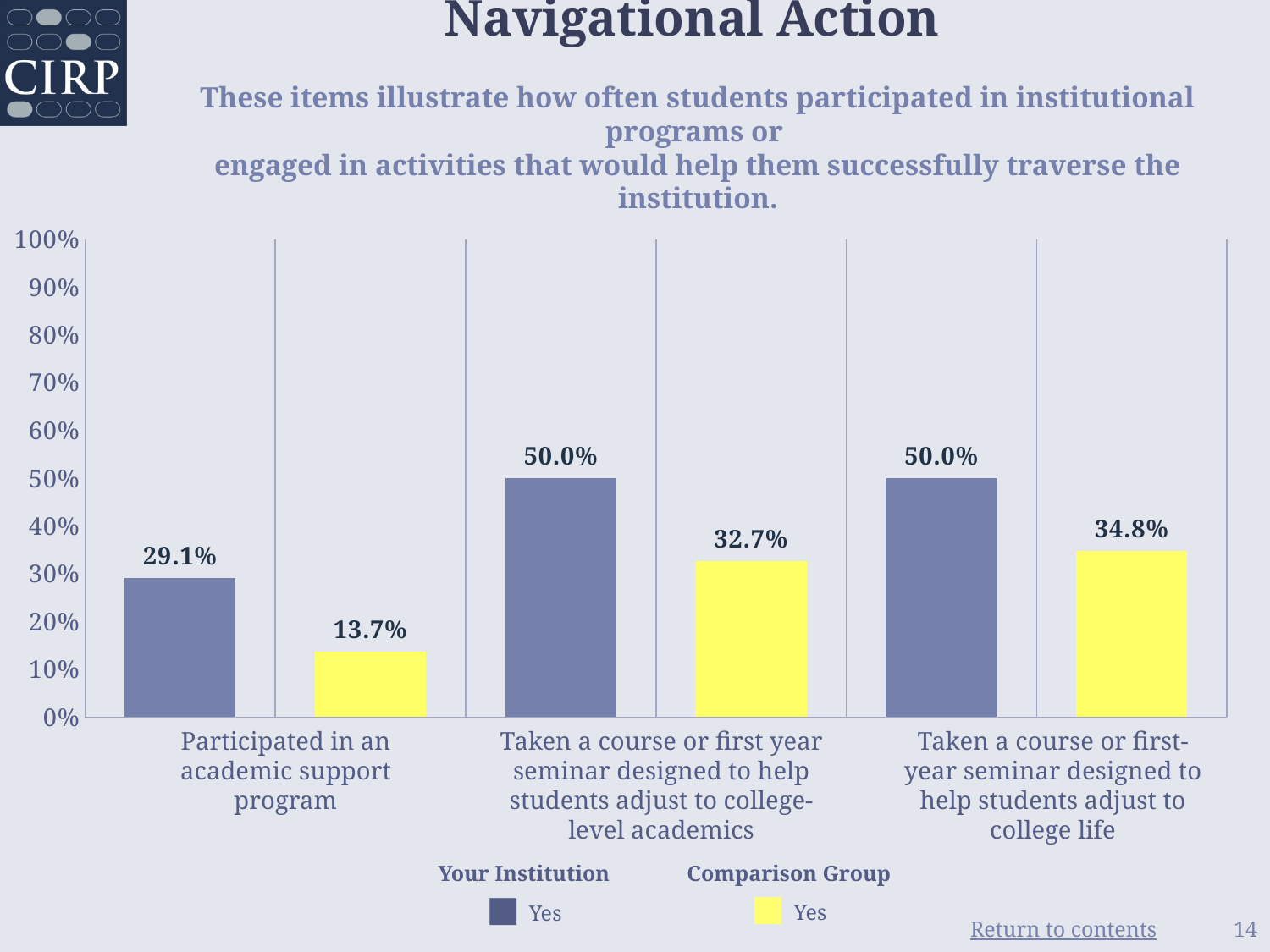
What is the value for Your Institution for 'Participated in an academic support program'? 29.1% What kind of chart is shown on the slide? Bar chart What is the Your Institution value for 'Taken a course or first-year seminar designed to help students adjust to college life'? 50.0% How many categories are shown on the x axis? 3 How many series does the legend list? 2 What is the Comparison Group value for 'Taken a course or first year seminar designed to help students adjust to college-level academics'? 32.7% What is the difference between Your Institution and the Comparison Group for 'Participated in an academic support program'? 15.4% Which is larger for 'Taken a course or first-year seminar designed to help students adjust to college life': Your Institution or the Comparison Group? Your Institution What is the Comparison Group value for 'Taken a course or first-year seminar designed to help students adjust to college life'? 34.8% What is the difference between Your Institution and the Comparison Group for 'Taken a course or first year seminar designed to help students adjust to college-level academics'? 17.3% Which category has the lowest Comparison Group value? Participated in an academic support program What is the value for the Comparison Group for 'Participated in an academic support program'? 13.7%